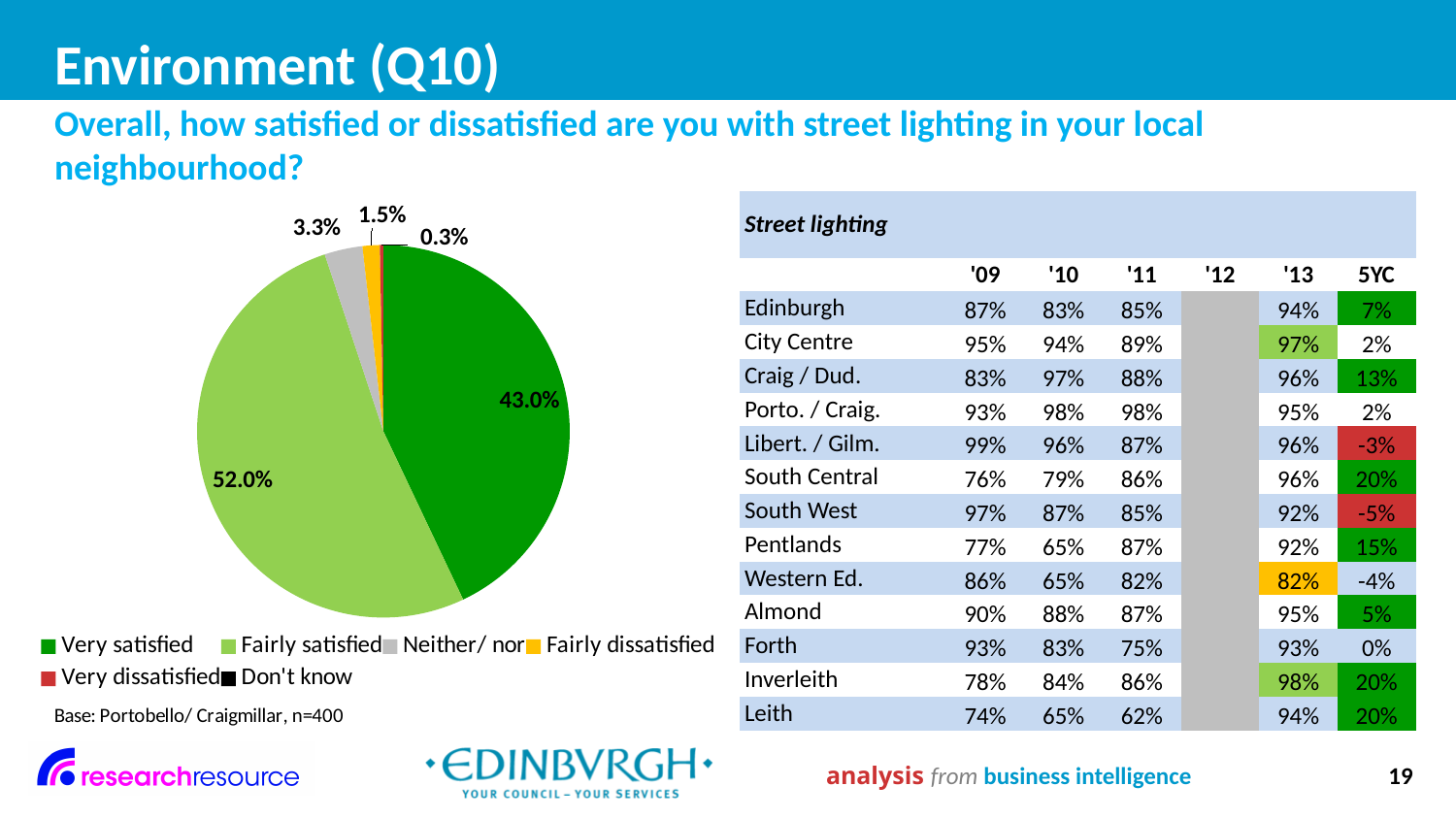
What share of the pie chart is 'Fairly satisfied'? 52.0% What share of the pie chart is 'Very dissatisfied'? 0.3% What share of the pie chart is 'Neither/ nor'? 3.3% Which category has the largest slice of the pie chart? Fairly satisfied Which labelled category has the smallest slice of the pie chart? Very dissatisfied What kind of chart is shown on the slide? pie chart What share of the pie chart is 'Very satisfied'? 43.0% What is the difference between the 'Fairly satisfied' and 'Very satisfied' shares in the pie chart? 9.0% What is the base sample size stated below the pie chart? Portobello/ Craigmillar, n=400 What share of the pie chart is 'Fairly dissatisfied'? 1.5% How many categories does the pie chart's legend list? 6 Which is larger in the pie chart, 'Neither/ nor' or 'Fairly dissatisfied'? Neither/ nor